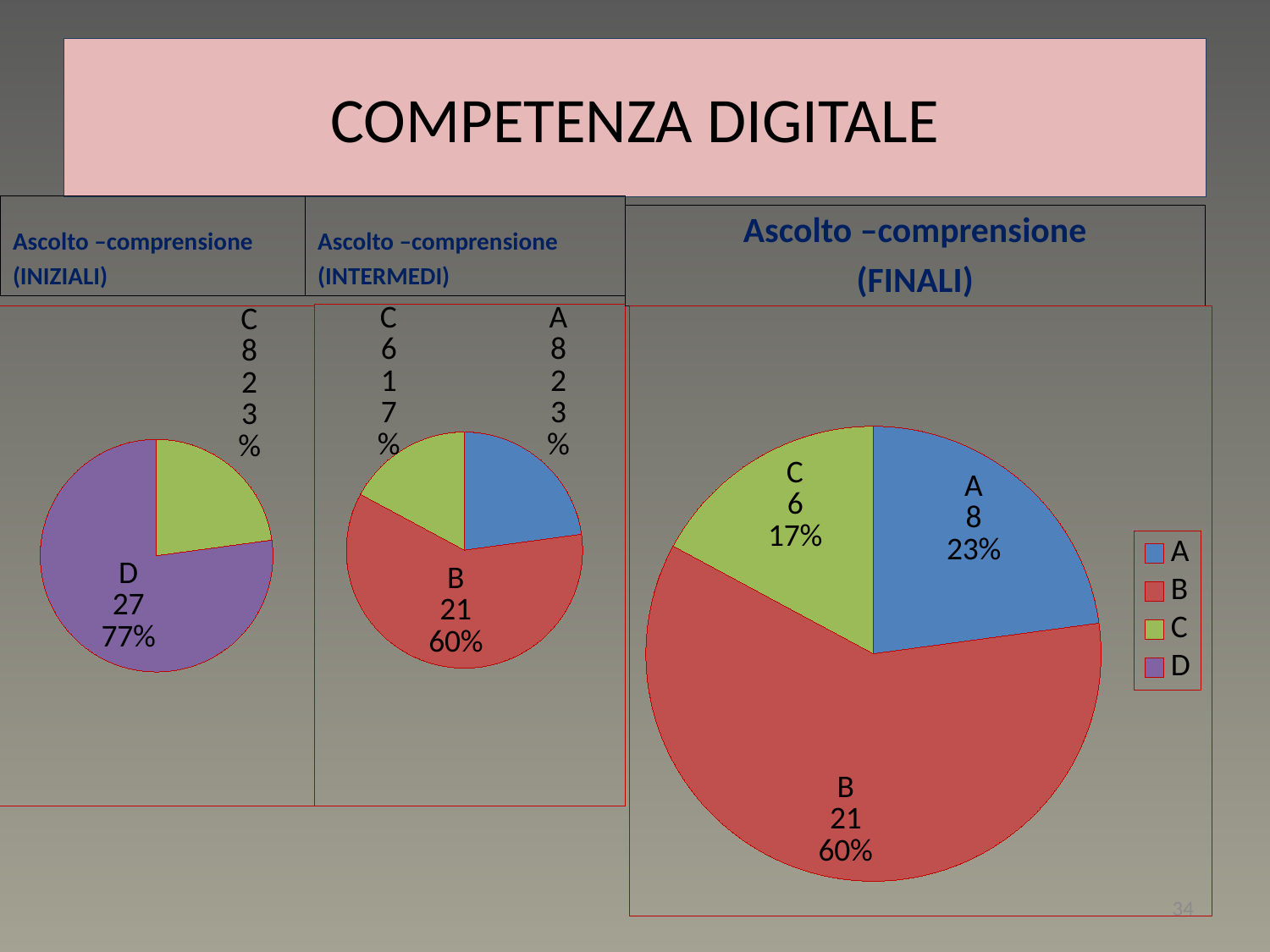
In the Ascolto –comprensione (FINALI) pie chart, what percentage is shown for A? 23% In the Ascolto –comprensione (FINALI) pie chart, what value is shown for B? 21 In the Ascolto –comprensione (INIZIALI) pie chart, which is larger, the slice for D or the slice for C? D In the Ascolto –comprensione (FINALI) pie chart, which category has the smallest slice? C In the Ascolto –comprensione (INIZIALI) pie chart, what value is shown for D? 27 What type of chart is the Ascolto –comprensione (FINALI) chart? Pie chart How many entries does the legend of the Ascolto –comprensione (FINALI) chart list? 4 In the Ascolto –comprensione (FINALI) pie chart, what percentage is shown for C? 17% In the Ascolto –comprensione (INIZIALI) pie chart, what percentage is shown for D? 77% In the Ascolto –comprensione (INTERMEDI) pie chart, what value is shown for B? 21 In the Ascolto –comprensione (FINALI) pie chart, which category has the largest slice? B In the Ascolto –comprensione (FINALI) pie chart, what is the difference between the values for B and A? 13